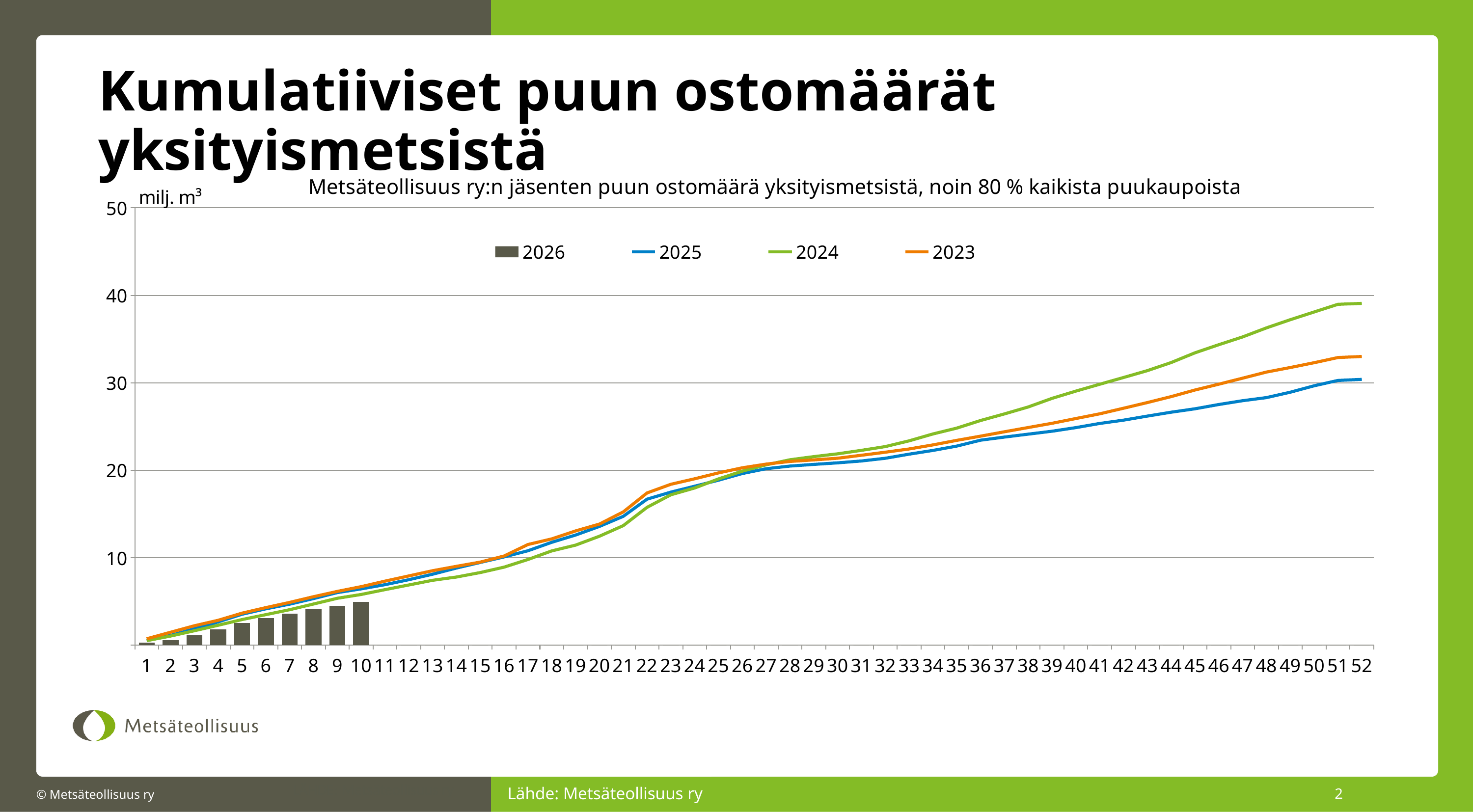
Which series has the highest value at week 52? 2024 How many series does the chart legend list? 4 What unit is shown on the y axis of the chart? milj. m³ How many week categories are shown on the x axis? 52 What kind of chart is shown on the slide? A combined bar and line chart For how many weeks are bars plotted for the 2026 series? 10 Is the value for 2025 at week 52 greater or less than 40? less Is the value for the 2026 bar at week 10 greater or less than 10? less At week 52, which is larger: the value for 2024 or the value for 2025? 2024 Which series has the lowest value at week 52? 2025 Is the value for 2024 at week 52 greater or less than 30? greater Do the line series rise or fall along the x axis from week 1 to week 52? rise